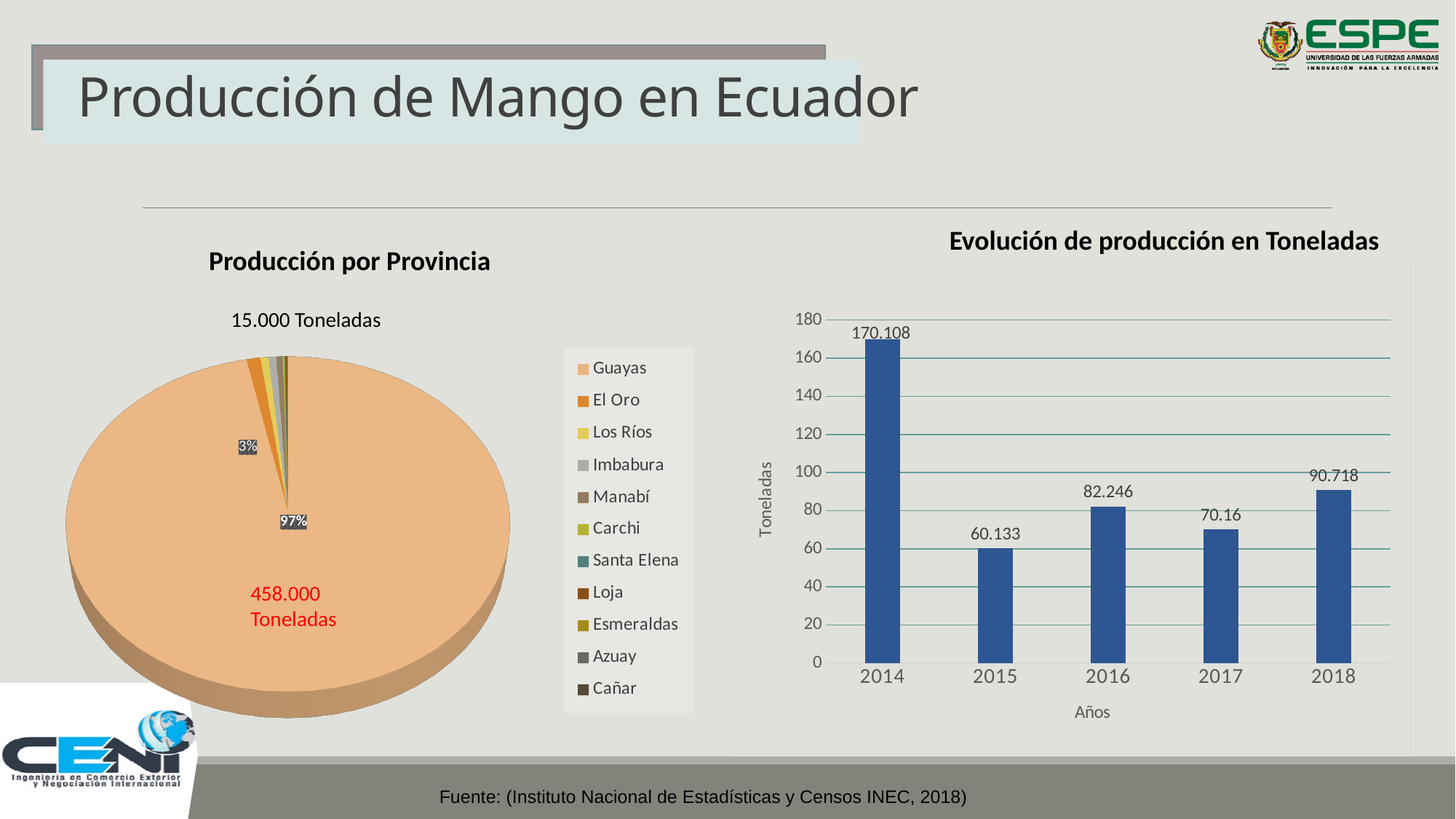
What kind of chart is 'Evolución de producción en Toneladas'? Bar chart In the 'Evolución de producción en Toneladas' chart, how many years are shown on the x axis? 5 In the 'Evolución de producción en Toneladas' chart, what is the difference between the values for 2014 and 2015? 109.975 How many entries does the legend of the 'Producción por Provincia' chart list? 11 In the 'Evolución de producción en Toneladas' chart, do the values rise or fall from 2015 to 2016? Rise In the 'Evolución de producción en Toneladas' chart, what is the value for 2017? 70.16 In the 'Producción por Provincia' chart, what share of the pie does Guayas have? 97% In the 'Evolución de producción en Toneladas' chart, which is larger, the value for 2016 or the value for 2018? 2018 In the 'Evolución de producción en Toneladas' chart, what is the value for 2014? 170.108 What kind of chart is 'Producción por Provincia'? Pie chart In the 'Evolución de producción en Toneladas' chart, which year has the highest value? 2014 In the 'Evolución de producción en Toneladas' chart, which year has the lowest value? 2015